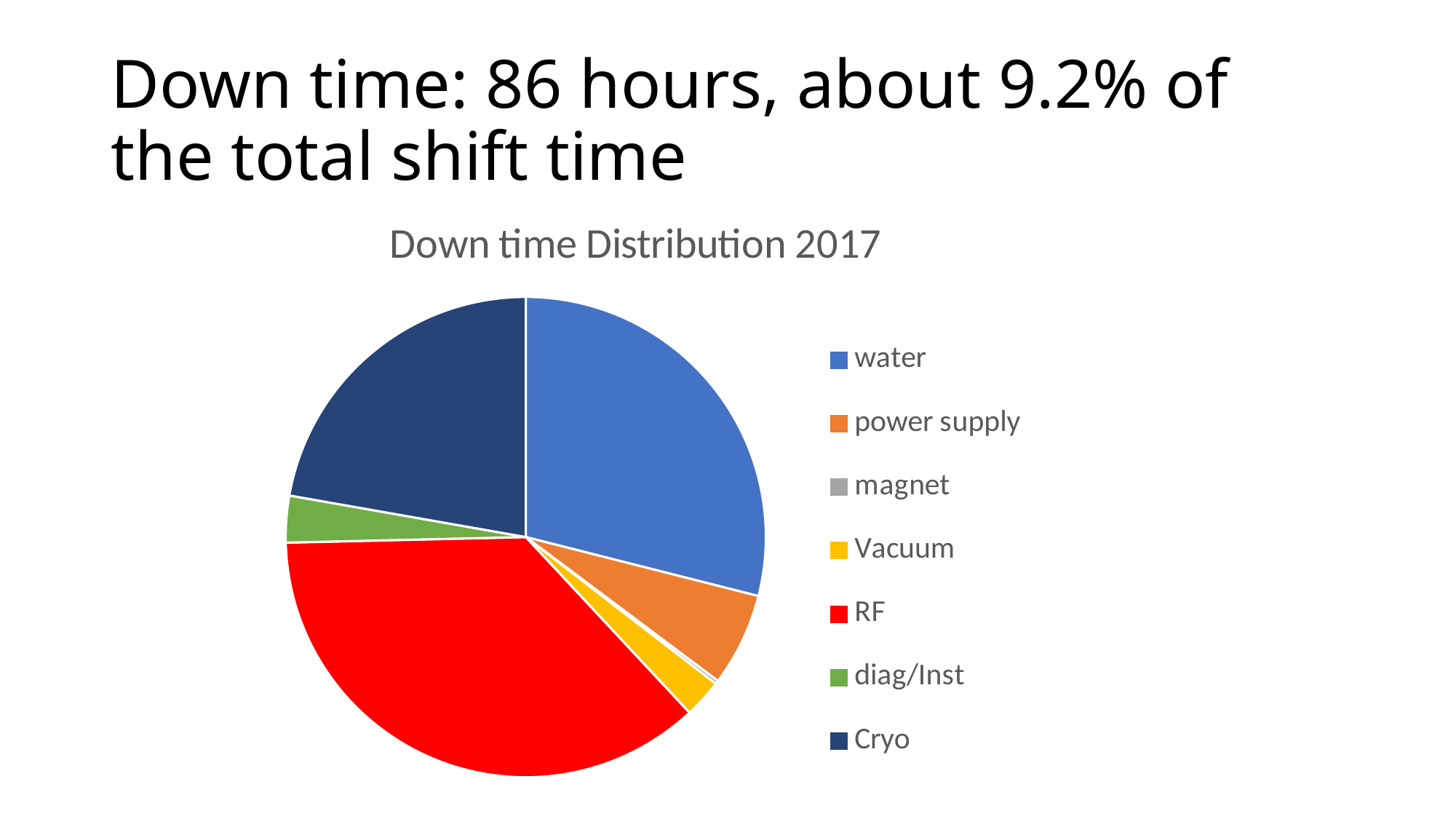
Which slice is larger, RF or water? RF Which slice is larger, water or power supply? water What colour is the RF slice in the pie chart? red How many categories does the pie chart have? 7 Which category has the smallest slice of the pie? magnet Which slice is larger, Vacuum or magnet? Vacuum What kind of chart is shown on the slide? pie chart Which category has the largest slice of the pie? RF What is the title of the chart? Down time Distribution 2017